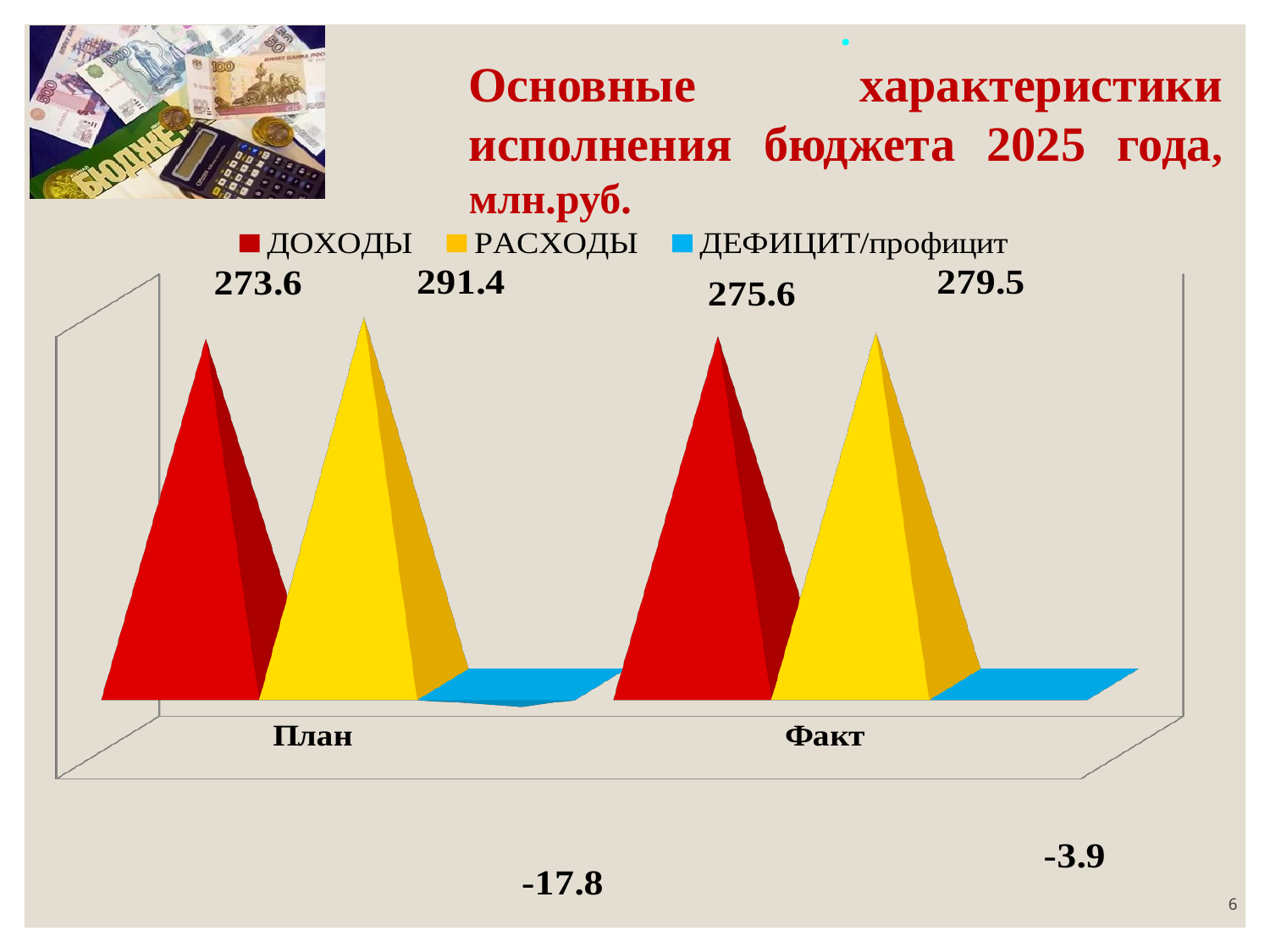
Which category has the higher value of РАСХОДЫ, План or Факт? План What is the value of ДЕФИЦИТ/профицит for Факт? -3.9 What is the difference between РАСХОДЫ and ДОХОДЫ for План? 17.8 What is the value of ДОХОДЫ for Факт? 275.6 What is the value of ДЕФИЦИТ/профицит for План? -17.8 What is the value of ДОХОДЫ for План? 273.6 How many categories are shown on the x axis? 2 How many series does the legend list? 3 What is the value of РАСХОДЫ for План? 291.4 What is the title of the chart? Основные характеристики исполнения бюджета 2025 года, млн.руб. Which is larger for Факт, ДОХОДЫ or РАСХОДЫ? РАСХОДЫ What is the value of РАСХОДЫ for Факт? 279.5